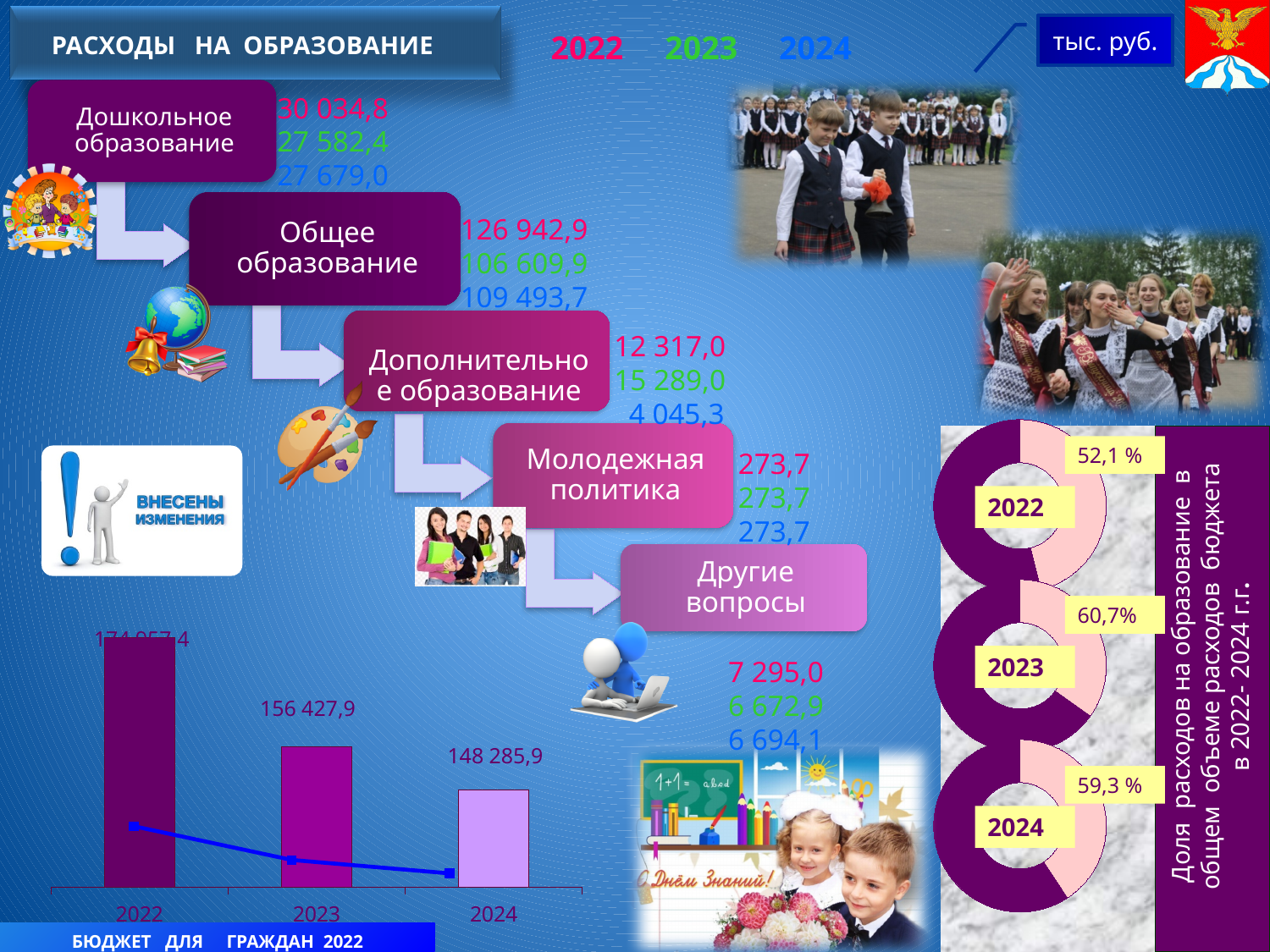
In the donut charts on the right of the slide, what share is shown for 2023? 60,7% In the bar chart at the bottom left, which year has the highest bar? 2022 In the bar chart at the bottom left, do the values rise or fall from 2022 to 2024? fall In the bar chart at the bottom left, what is the value for 2024? 148 285,9 In the bar chart at the bottom left, what is the value for 2023? 156 427,9 In the bar chart at the bottom left, what is the difference between the values for 2023 and 2024? 8 142,0 In the donut charts on the right of the slide, which year has the highest share? 2023 In the bar chart at the bottom left, which year has the lowest bar? 2024 In the donut charts on the right of the slide, what share is shown for 2022? 52,1 % What kind of chart is the chart at the bottom left of the slide? bar chart In the bar chart at the bottom left, which is larger, the value for 2023 or the value for 2024? 2023 In the bar chart at the bottom left, how many years are shown on the x axis? 3